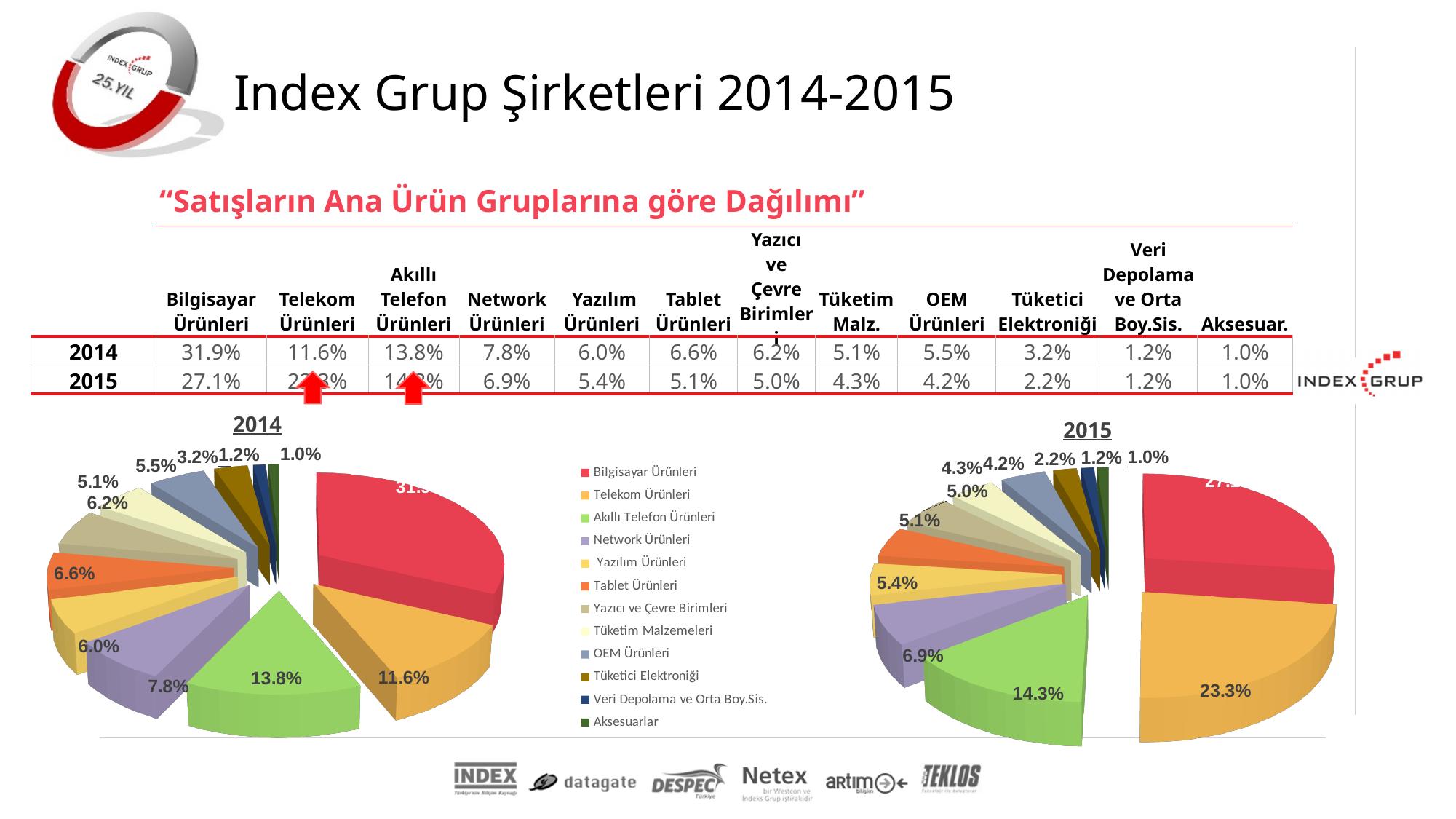
What colour is the Bilgisayar Ürünleri slice in the pie charts? red In the 2014 pie chart, which is larger: Telekom Ürünleri or Akıllı Telefon Ürünleri? Akıllı Telefon Ürünleri In the 2015 pie chart, what is the share for Network Ürünleri? 6.9% In the 2015 pie chart, which category has the largest slice? Bilgisayar Ürünleri How many entries does the shared legend between the two pie charts list? 12 In the 2014 pie chart, which category has the smallest slice? Aksesuarlar How many slices does the 2015 pie chart have? 12 In the 2015 pie chart, what is the share for Telekom Ürünleri? 23.3% What kind of chart is the 2014 chart on the left? pie chart What is the difference between the Telekom Ürünleri share in the 2015 pie chart and in the 2014 pie chart? 11.7% In the 2014 pie chart, what is the share for Tablet Ürünleri? 6.6% In the 2014 pie chart, what is the share for Akıllı Telefon Ürünleri? 13.8%